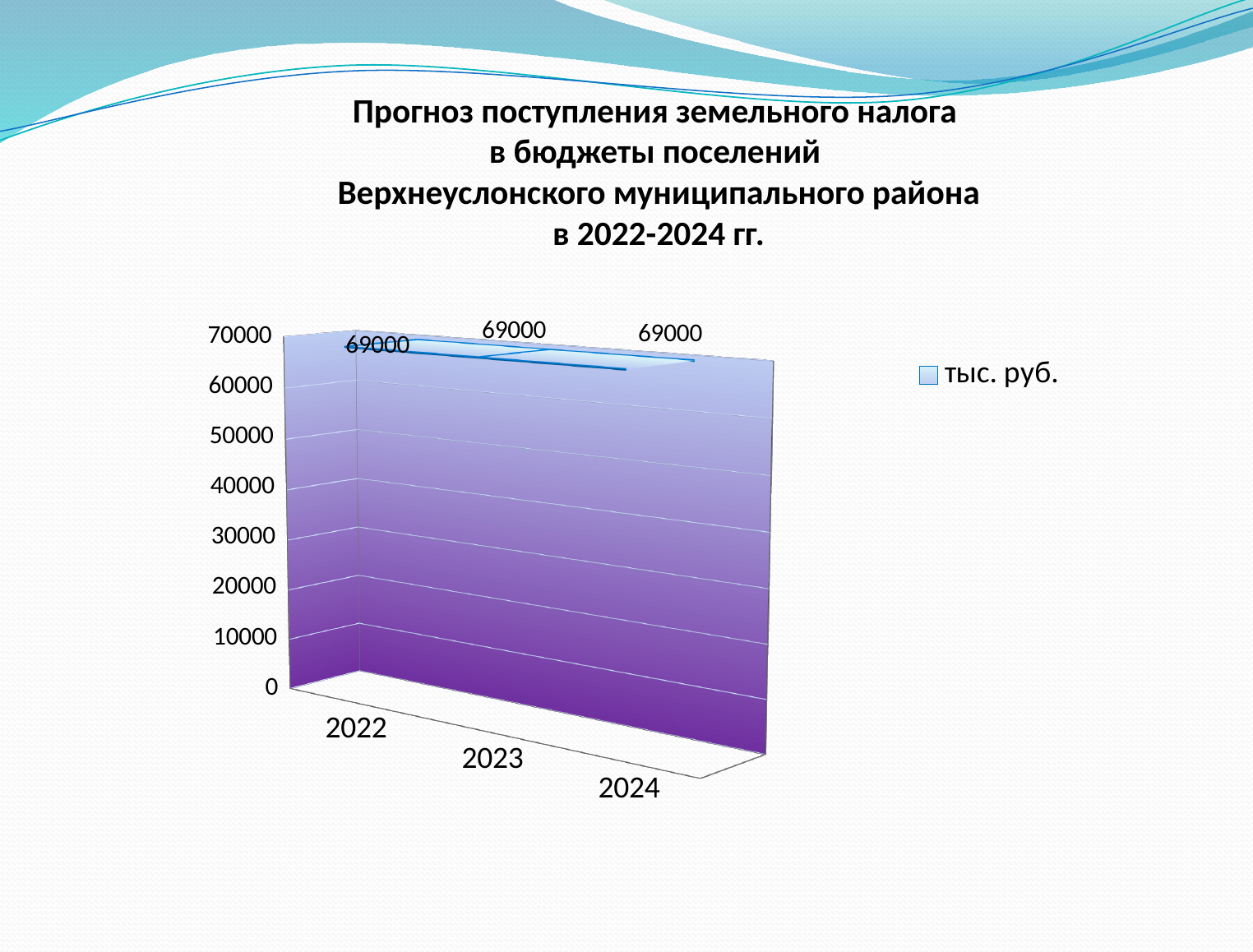
What kind of chart is shown on the slide? line chart Do the values rise, fall or stay the same from 2022 to 2024? stay the same What is the forecast land tax value for 2022? 69000 What is the forecast land tax value for 2023? 69000 Is the value for 2023 greater or less than 60000? greater What is the difference between the values for 2022 and 2024? 0 What is the legend entry of the chart? тыс. руб. Is the value for 2022 greater or less than 70000? less What is the highest value shown on the vertical axis? 70000 What is the forecast land tax value for 2024? 69000 How many years are shown on the x axis? 3 How many series does the legend list? 1